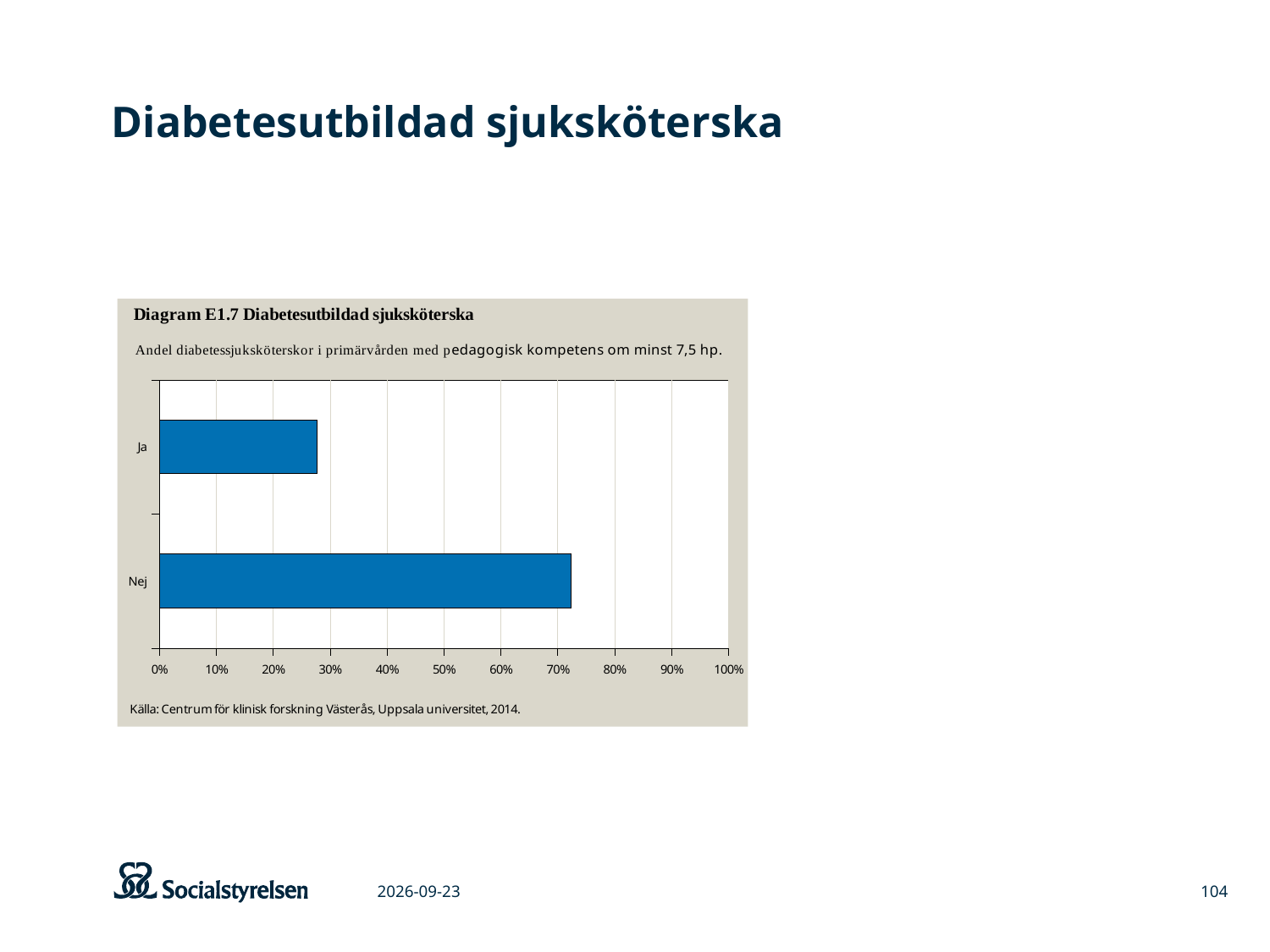
Is the value for Nej greater or less than 80%? less How many categories are plotted in the chart? 2 Is the value for Ja greater or less than 20%? greater Which category has the lowest value? Ja Is the value for Ja greater or less than 30%? less Which category has the highest value? Nej What is the highest value shown on the x axis of the chart? 100% What is the title of the diagram shown on the slide? Diagram E1.7 Diabetesutbildad sjuksköterska What kind of chart is shown on the slide? bar chart Which is larger, the value for Ja or the value for Nej? Nej